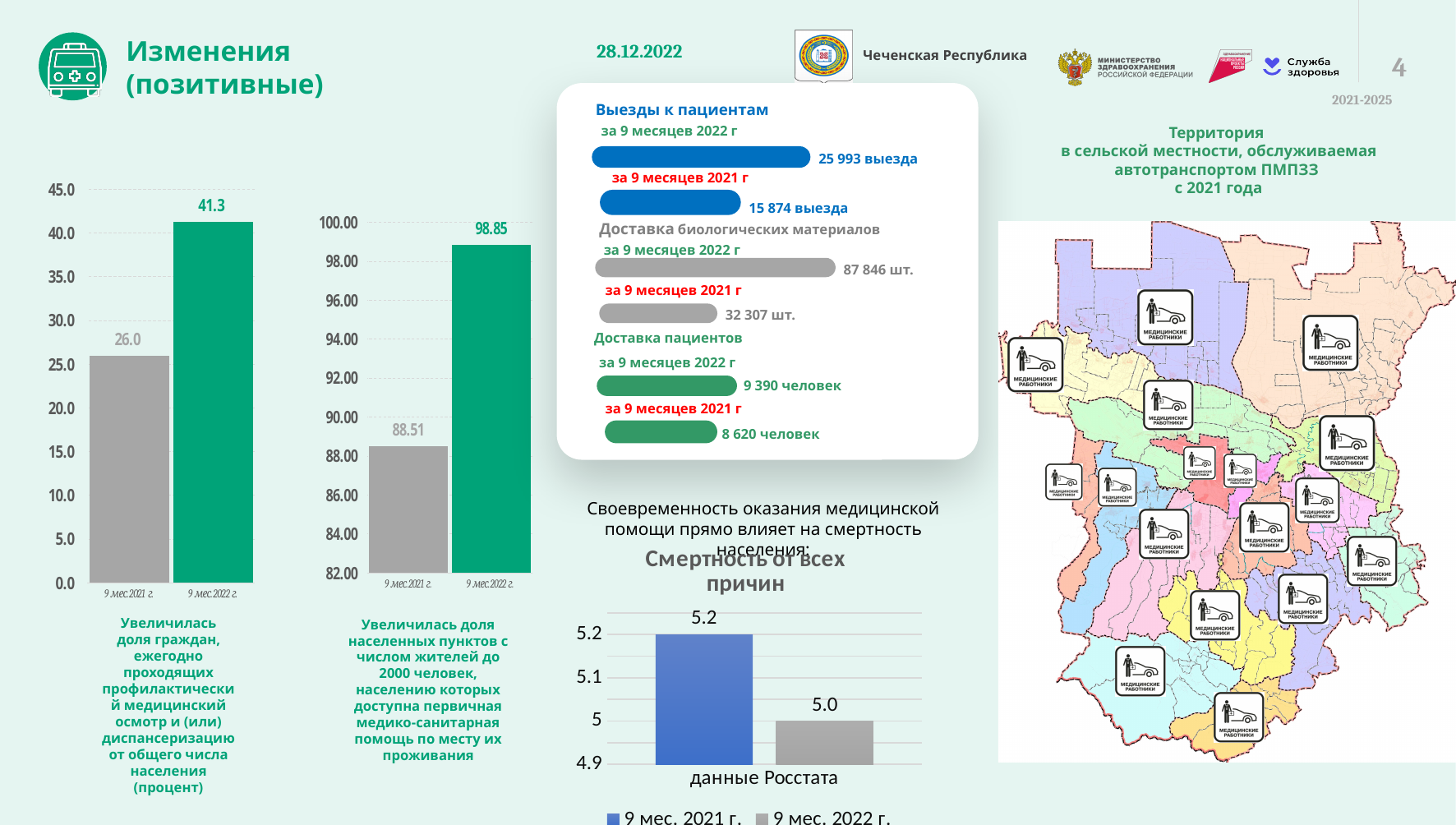
In the leftmost bar chart, what is the value for 9 мес. 2022 г.? 41.3 In the leftmost bar chart, what is the difference between the 2022 and 2021 values? 15.3 In the chart titled 'Смертность от всех причин', how many series does the legend list? 2 In the leftmost bar chart, what is the value for 9 мес. 2021 г.? 26.0 What kind of chart is 'Смертность от всех причин'? bar chart In the chart titled 'Смертность от всех причин', what is the value for 9 мес. 2022 г.? 5.0 In the second bar chart from the left, which category has the higher value? 9 мес. 2022 г. In the chart titled 'Смертность от всех причин', what is the value for 9 мес. 2021 г.? 5.2 In the second bar chart from the left, what is the value for 9 мес. 2022 г.? 98.85 In the second bar chart from the left, what is the value for 9 мес. 2021 г.? 88.51 In the 'Доставка биологических материалов' infographic, what is the value for 9 months of 2021? 32 307 шт. In the 'Выезды к пациентам' infographic, how many visits were made in 9 months of 2022? 25 993 выезда